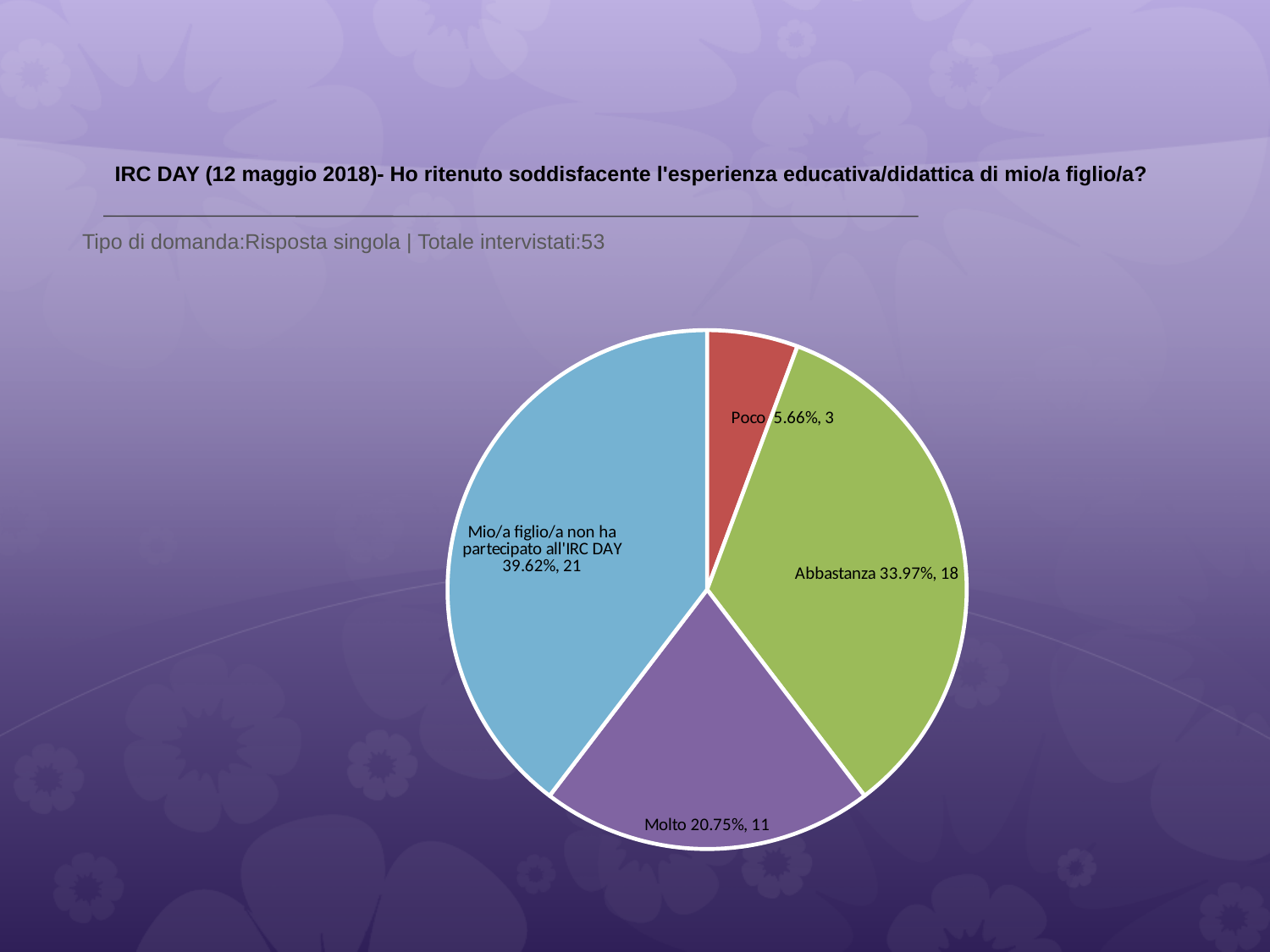
How many slices does the pie chart have? 4 What is the total number of respondents stated on the slide? 53 What percentage share does the 'Abbastanza' slice have? 33.97% Which category has the smallest slice of the pie? Poco Which has more respondents, 'Molto' or 'Abbastanza'? Abbastanza How many respondents answered 'Mio/a figlio/a non ha partecipato all'IRC DAY'? 21 What colour is the 'Molto' slice? purple What percentage share does the 'Poco' slice have? 5.66% How many respondents answered 'Molto'? 11 What kind of chart is shown on the slide? pie chart Which category has the largest slice of the pie? Mio/a figlio/a non ha partecipato all'IRC DAY What is the difference in number of respondents between 'Abbastanza' and 'Molto'? 7